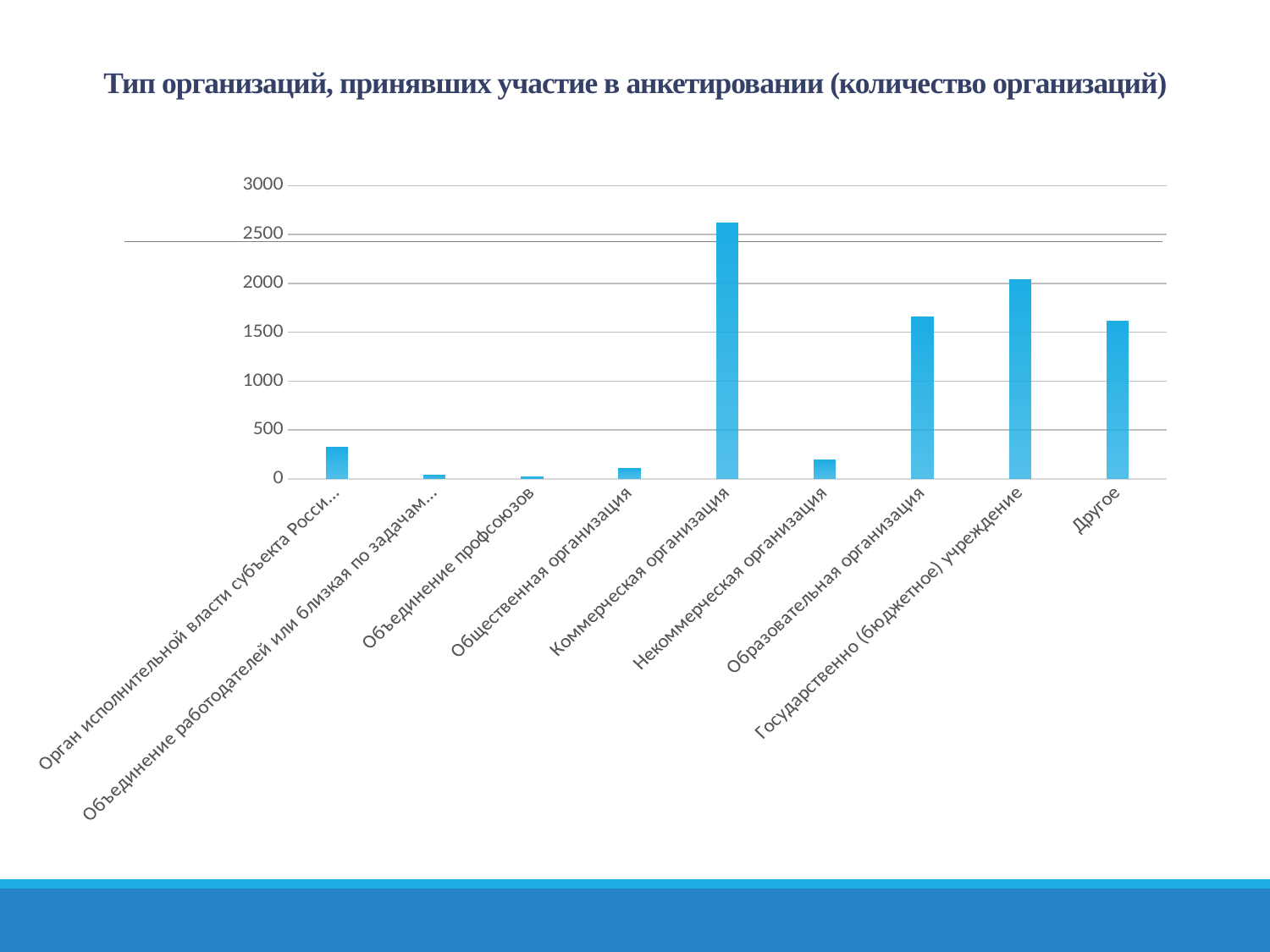
Which is larger: the value for Некоммерческая организация or the value for Общественная организация? Некоммерческая организация Is the value for Другое greater or less than 2000? less Is the value for Коммерческая организация greater or less than 2500? greater Which organisation type has the highest number of organisations? Коммерческая организация Is the value for Некоммерческая организация greater or less than 500? less What kind of chart is shown on the slide? bar chart How many categories (organisation types) are shown on the x axis? 9 Which is larger: the value for Государственно (бюджетное) учреждение or the value for Образовательная организация? Государственно (бюджетное) учреждение What is the title of the chart? Тип организаций, принявших участие в анкетировании (количество организаций)